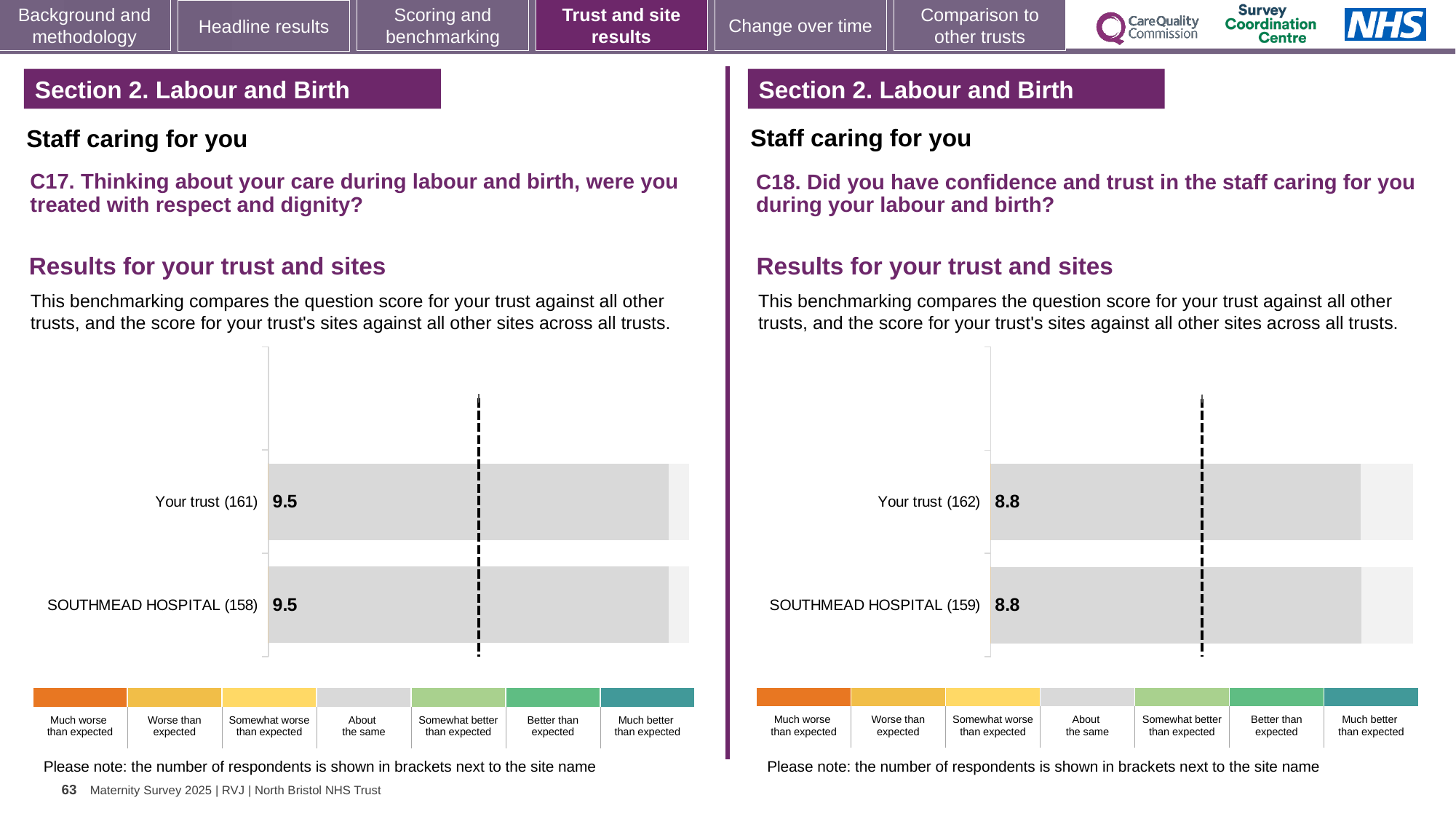
In the C17 chart on the left, what is the score for SOUTHMEAD HOSPITAL? 9.5 In the C18 chart on the right, how many respondents are shown in brackets for SOUTHMEAD HOSPITAL? 159 In the C18 chart on the right, what is the score for Your trust? 8.8 In the C18 chart on the right, what is the score for SOUTHMEAD HOSPITAL? 8.8 What kind of chart is used for the C17 results on the left? Bar chart In the C18 chart on the right, which benchmark category does the grey colour of the bars correspond to in the legend? About the same What is the difference between the SOUTHMEAD HOSPITAL score in the C17 chart on the left and the SOUTHMEAD HOSPITAL score in the C18 chart on the right? 0.7 Which is larger: the Your trust score in the C17 chart on the left or the Your trust score in the C18 chart on the right? C17 chart (9.5) How many bars are plotted in the C17 chart on the left? 2 In the C17 chart on the left, how many respondents are shown in brackets for Your trust? 161 How many bars are plotted in the C18 chart on the right? 2 In the C17 chart on the left, what is the score for Your trust? 9.5